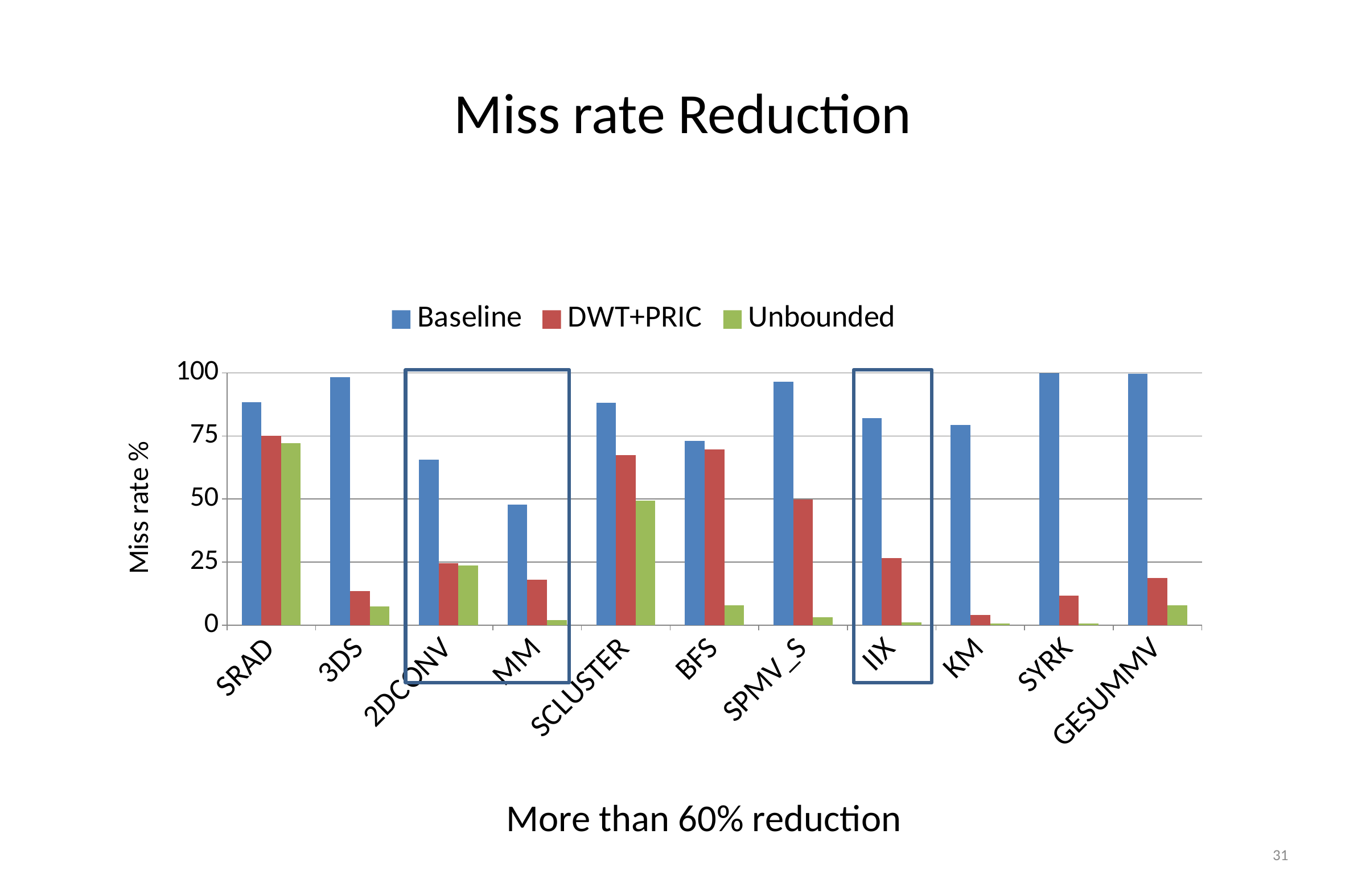
Which category has the lowest Baseline miss rate? MM Is the Baseline miss rate for MM greater or less than 50? less How many series does the legend list? 3 Which category has the highest Unbounded miss rate? SRAD Which category has the lowest DWT+PRIC miss rate? KM What kind of chart is shown on the slide? bar chart Which is larger, the DWT+PRIC miss rate for SPMV_S or for IIX? SPMV_S What is the label of the y axis? Miss rate % Is the DWT+PRIC miss rate for 3DS greater or less than 25? less Which is larger, the Baseline miss rate for SRAD or for MM? SRAD How many benchmark categories are shown on the x axis? 11 Is the DWT+PRIC miss rate for SRAD greater or less than 50? greater